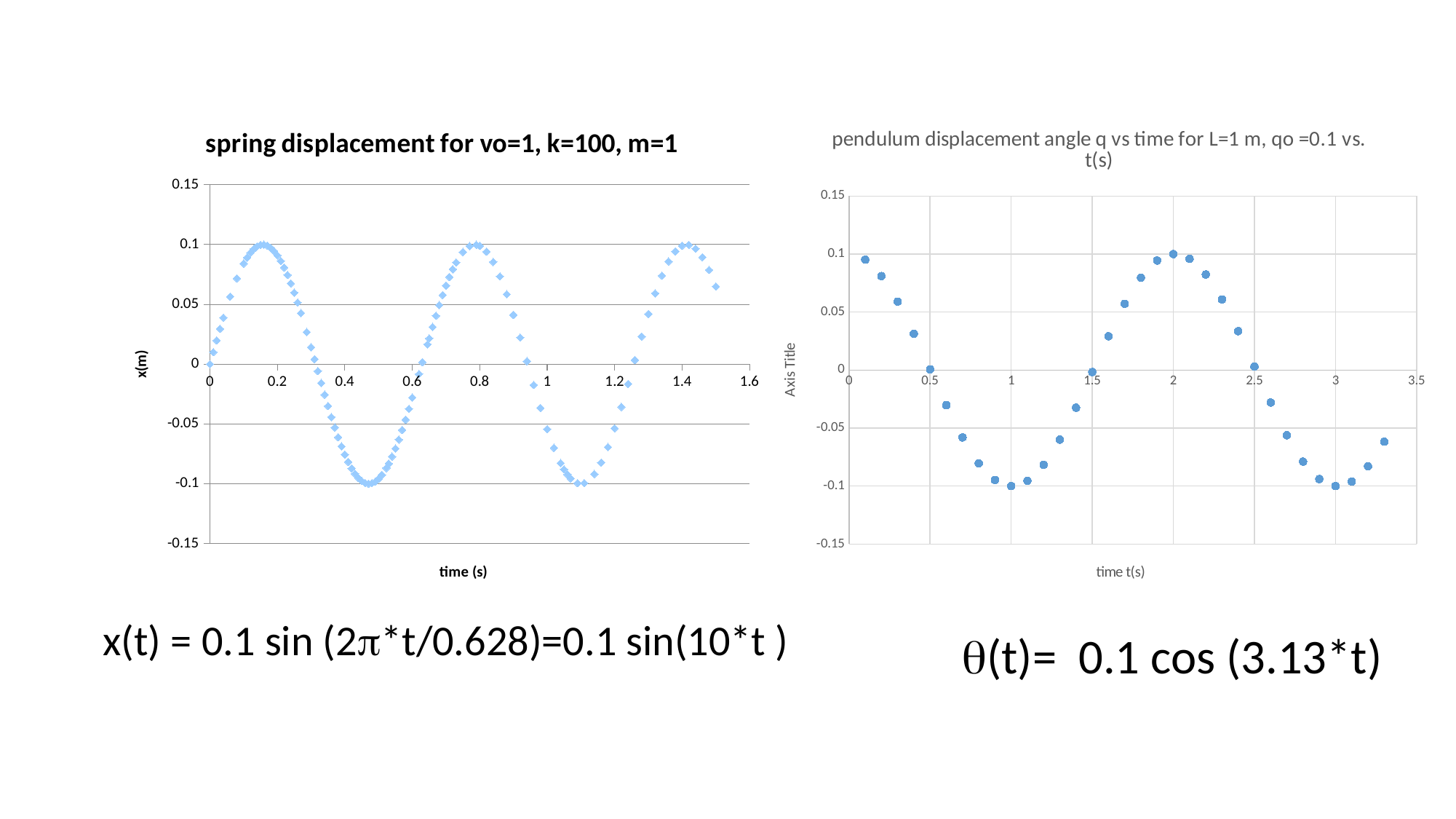
What is the y-axis title of the spring displacement chart? x(m) How many data points are plotted in the pendulum displacement angle chart? 33 In the pendulum displacement angle chart, is the value at t = 2.8 s greater or less than -0.05? less In the pendulum displacement angle chart, which is larger: the value at t = 0.1 s or the value at t = 1 s? t = 0.1 s In the pendulum displacement angle chart, what is the value at t = 1 s? -0.1 In the pendulum displacement angle chart, do the values rise or fall between t = 0.1 s and t = 1 s? fall What kind of chart is the 'spring displacement for vo=1, k=100, m=1' chart? scatter chart In the spring displacement chart, what is the value of x at time 0 s? 0 In the pendulum displacement angle chart, is the value at t = 0.2 s greater or less than 0.05? greater What is the x-axis title of the pendulum displacement angle chart? time t(s) In the pendulum displacement angle chart, what is the value at t = 2 s? 0.1